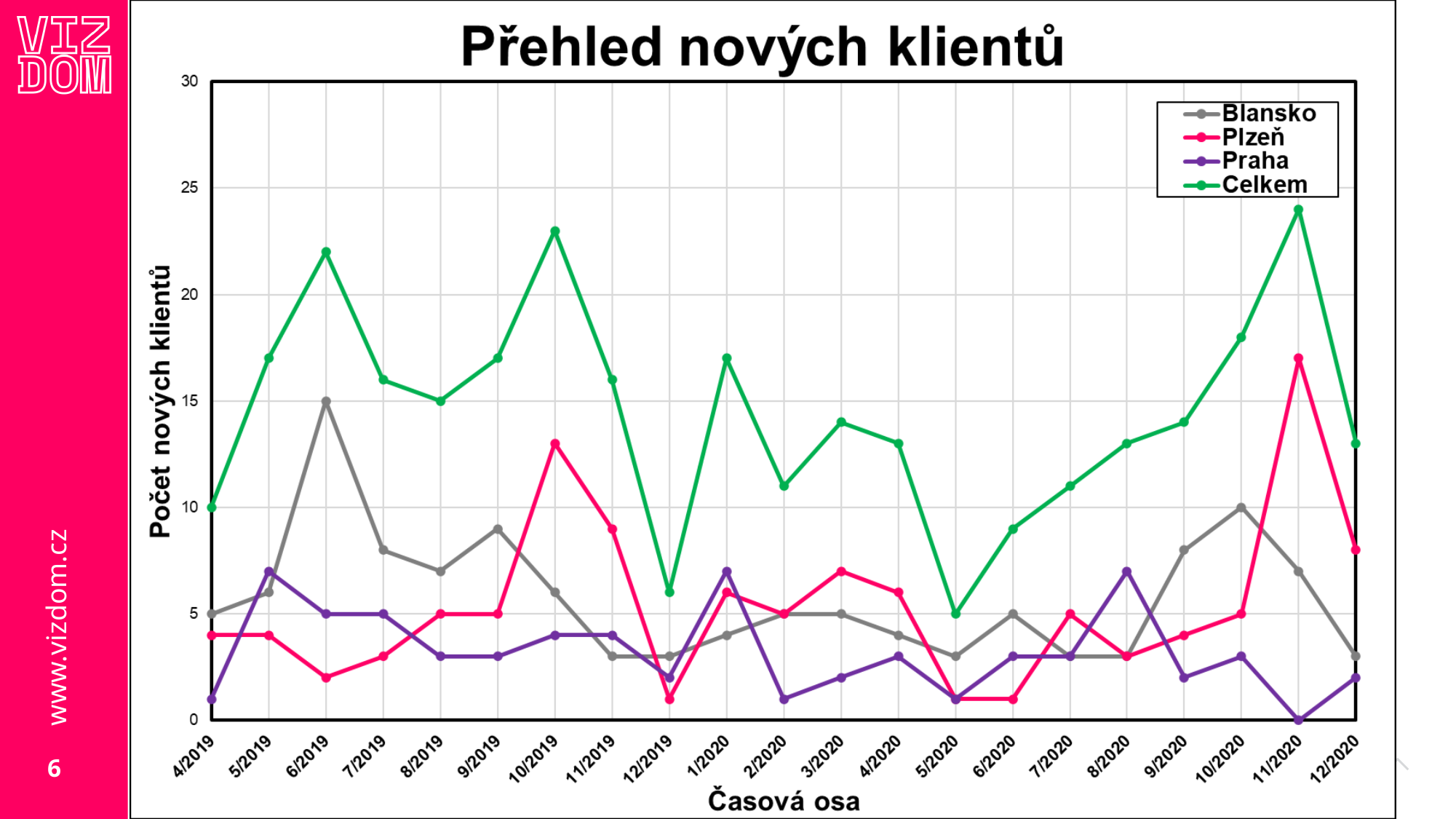
What type of chart is shown on the slide? line chart What is the title of the chart? Přehled nových klientů In which month does Plzeň reach its highest value? 11/2020 Which is larger in 6/2019, Blansko or Plzeň? Blansko What is the label of the y axis? Počet nových klientů What is the value for Blansko in 6/2019? 15 How many time points are shown on the x axis? 21 What is the value for Celkem in 4/2019? 10 In which month does Blansko reach its highest value? 6/2019 What is the value for Praha in 11/2020? 0 How many series does the legend list? 4 Is the value for Celkem in 11/2020 greater or less than 20? greater